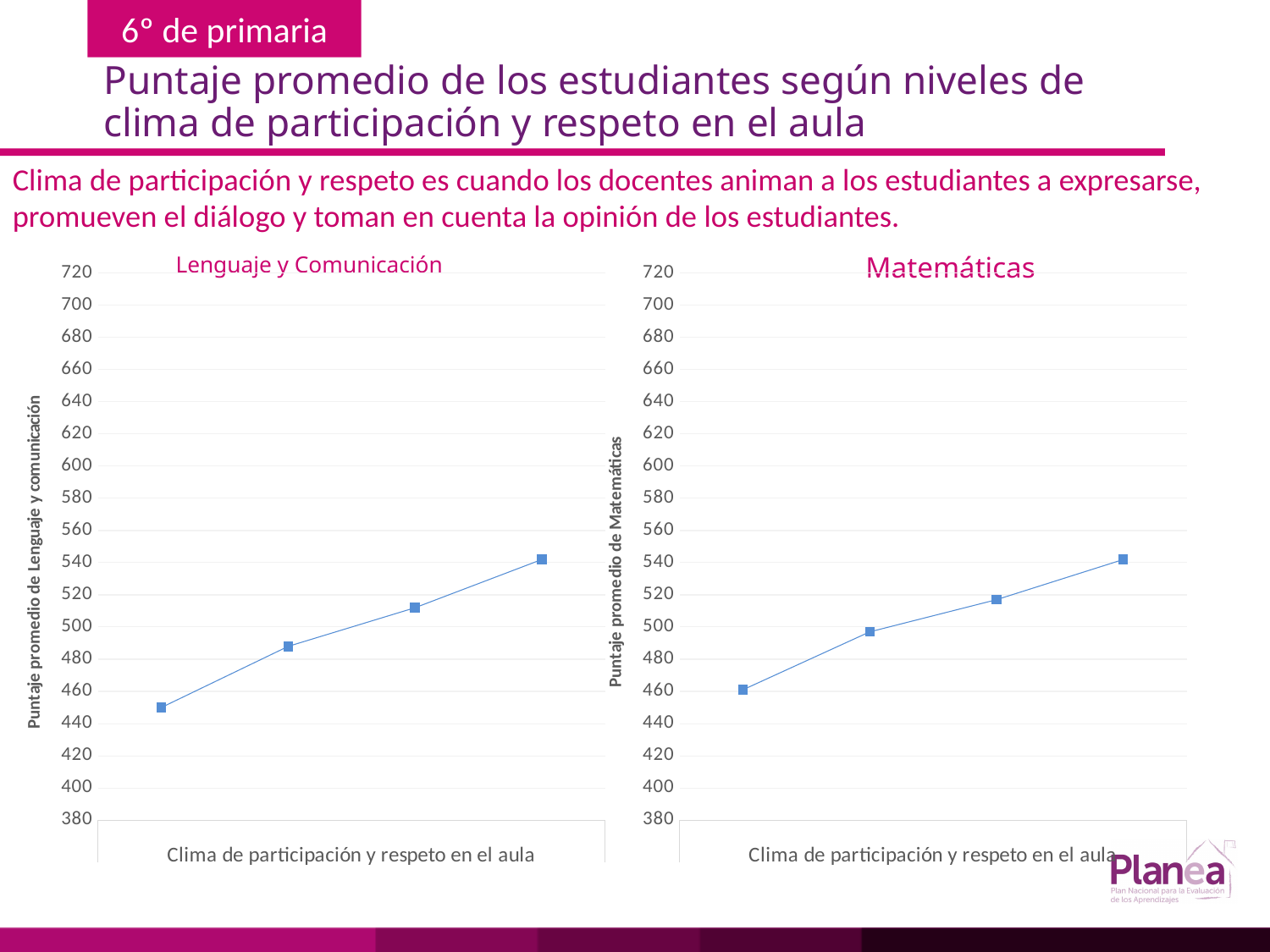
In the Lenguaje y Comunicación chart, is the value of the last (rightmost) point greater or less than 520? greater What is the x-axis label shown under the Lenguaje y Comunicación chart? Clima de participación y respeto en el aula What kind of chart is the Lenguaje y Comunicación chart? line chart In the Matemáticas chart, is the value of the last (rightmost) point greater or less than 520? greater In the Matemáticas chart, how many data points are plotted? 4 In the Matemáticas chart, do the values rise or fall from left to right along the x axis? rise In the Lenguaje y Comunicación chart, how many data points are plotted? 4 What kind of chart is the Matemáticas chart? line chart What is the y-axis title of the Matemáticas chart? Puntaje promedio de Matemáticas In the Matemáticas chart, is the value of the first (leftmost) point greater or less than 480? less In the Lenguaje y Comunicación chart, do the values rise or fall from left to right along the x axis? rise